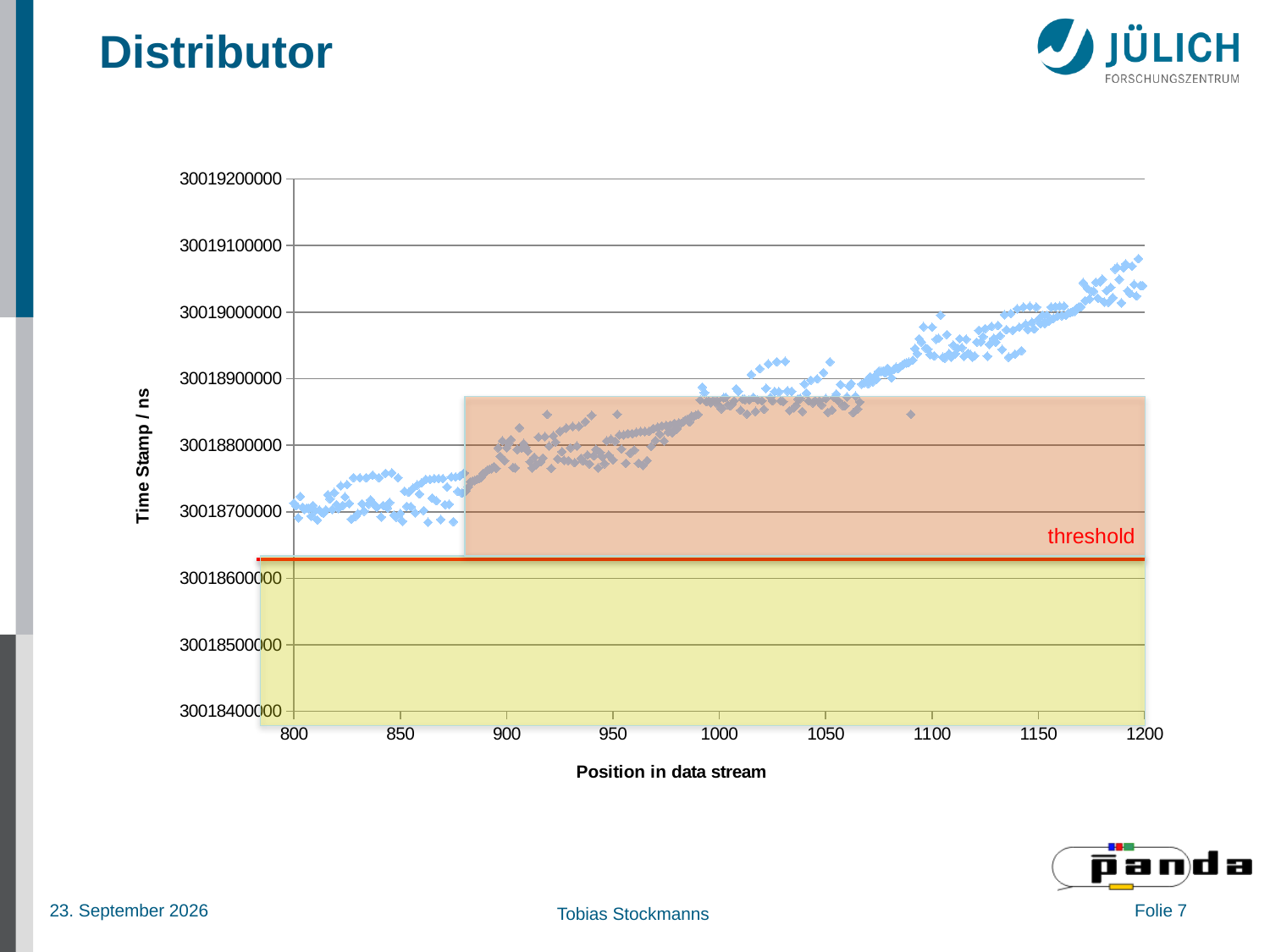
Is the red threshold line above or below 30018700000 on the y axis? below What kind of chart is shown on the slide? scatter chart How many tick labels are shown on the x axis? 9 Is the time stamp value at position 1100 greater or less than 30018900000? greater Is the time stamp value at position 1000 greater or less than 30018800000? greater Do the time stamp values rise or fall as the position in the data stream increases from 800 to 1200? rise What is the title of the y axis of the chart? Time Stamp / ns What is the title of the x axis of the chart? Position in data stream What is the lowest value labelled on the y axis? 30018400000 Which position has the larger time stamp value, 800 or 1200? 1200